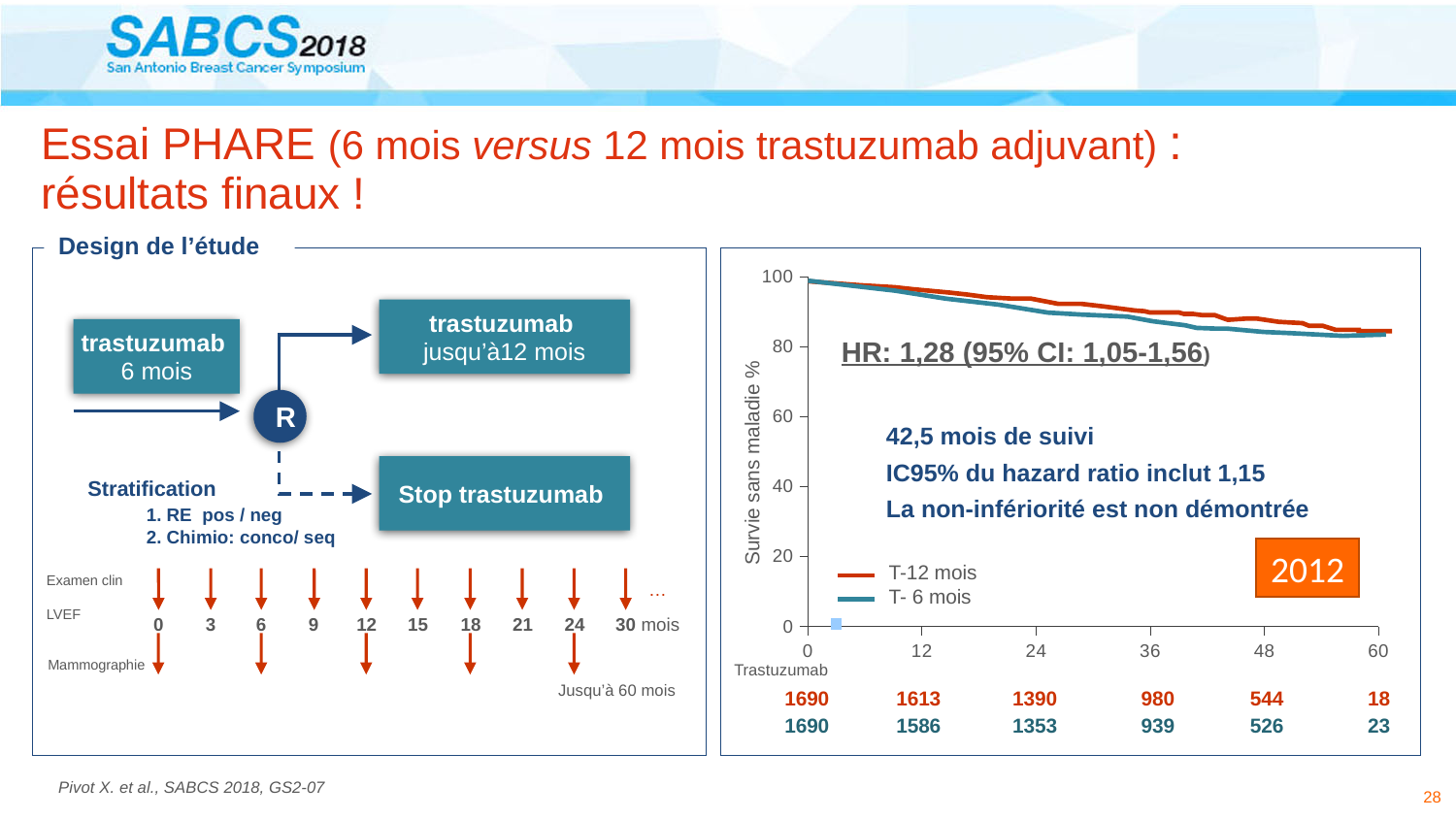
In the numbers-at-risk table, which group has more patients at risk at 24 months, T-12 mois or T- 6 mois? T-12 mois How many series does the legend of the survival chart list? 2 Is the disease-free survival value for T-12 mois at 60 months greater or less than 80? greater In the numbers-at-risk table, what is the difference between the T-12 mois and T- 6 mois numbers at 12 months? 27 In the numbers-at-risk table below the survival chart, how many patients in the T-12 mois group are at risk at 36 months? 980 Is the disease-free survival value for T- 6 mois at 24 months greater or less than 80? greater Do the survival curves rise or fall as time increases along the x axis? fall What is the label of the y axis of the survival chart? Survie sans maladie % How many tick marks are labelled on the x axis of the survival chart? 6 What kind of chart is shown on the right side of the slide? line chart What are the two series named in the legend of the survival chart? T-12 mois and T- 6 mois In the numbers-at-risk table below the survival chart, how many patients in the T- 6 mois group are at risk at 48 months? 526